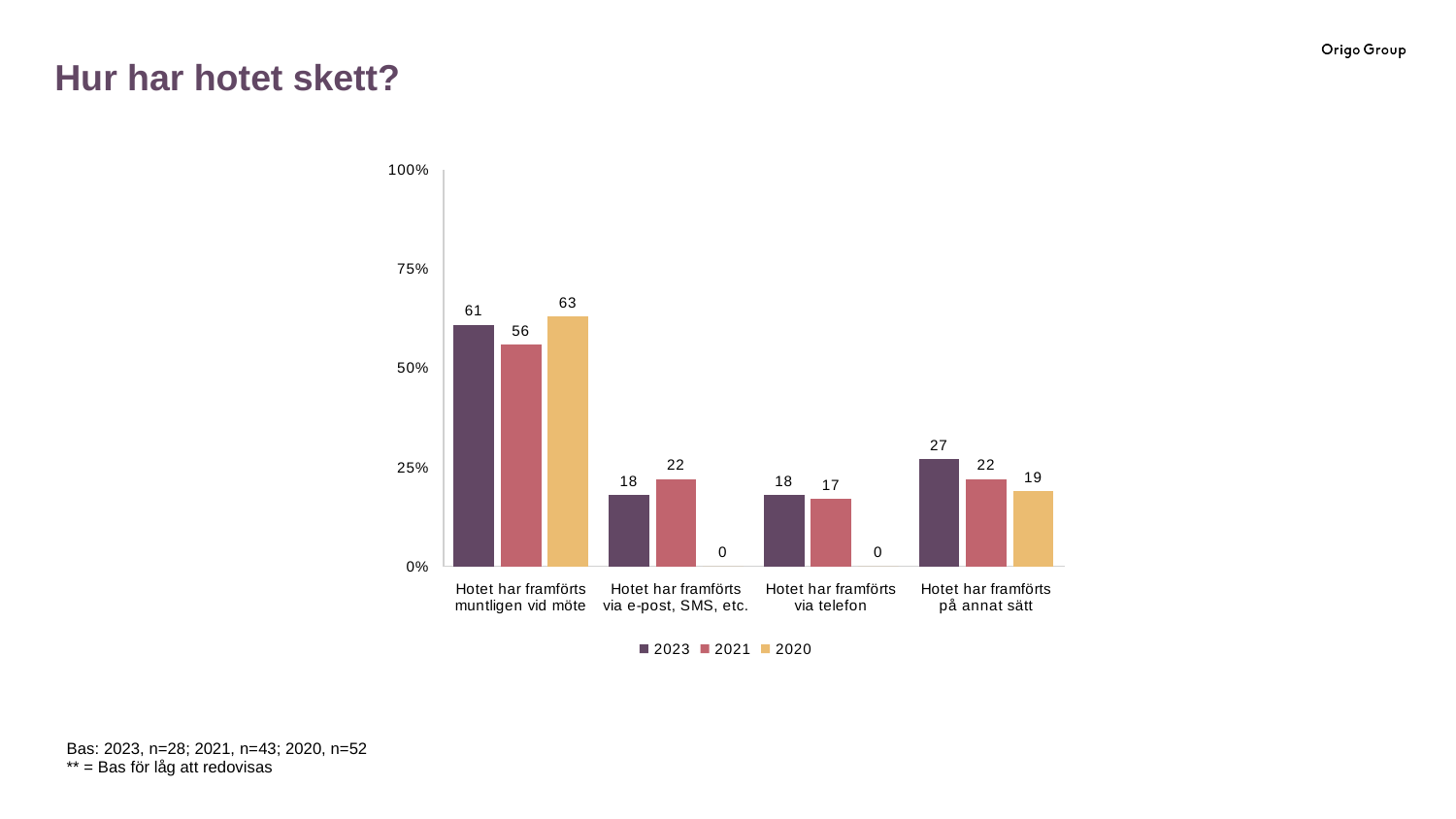
Is the 2023 value for "Hotet har framförts på annat sätt" greater or less than 25%? greater How many categories are shown on the x axis? 4 What is the difference between the 2020 and 2021 values for "Hotet har framförts muntligen vid möte"? 7 What is the value for 2023 in the category "Hotet har framförts muntligen vid möte"? 61 Which is larger for "Hotet har framförts på annat sätt": the 2023 value or the 2020 value? 2023 What is the title of the slide? Hur har hotet skett? What is the value for 2021 in the category "Hotet har framförts via telefon"? 17 What is the value for 2020 in the category "Hotet har framförts via e-post, SMS, etc."? 0 Which category has the lowest value for the 2023 series? Hotet har framförts via e-post, SMS, etc. and Hotet har framförts via telefon (both 18) What kind of chart is shown on the slide? Bar chart How many series does the legend list? 3 Which category has the highest value for the 2020 series? Hotet har framförts muntligen vid möte